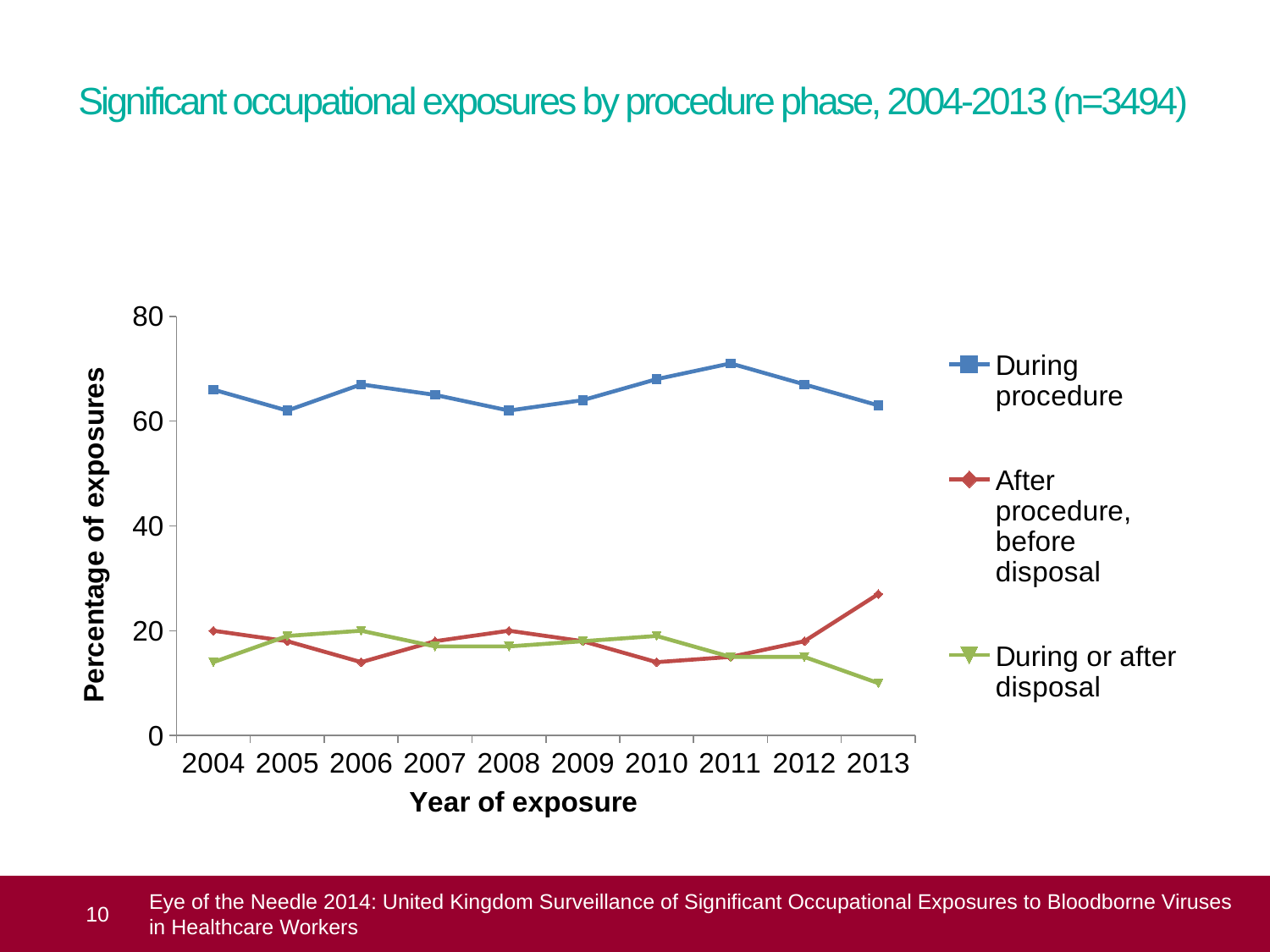
How many years are plotted along the x axis? 10 Is the value for 'During procedure' in 2011 greater or less than 60? greater Is the value for 'After procedure, before disposal' in 2013 greater or less than 20? greater What kind of chart is shown on the slide? Line chart In 2013, which series has the larger value: 'After procedure, before disposal' or 'During or after disposal'? After procedure, before disposal In which year does the 'During procedure' series reach its highest value? 2011 How many series does the legend list? 3 In which year does the 'During or after disposal' series reach its lowest value? 2013 What is the title of the y axis? Percentage of exposures Does the 'During or after disposal' series rise or fall from 2010 to 2013? Fall In which year does the 'After procedure, before disposal' series reach its highest value? 2013 Is the value for 'During or after disposal' in 2013 greater or less than 20? less